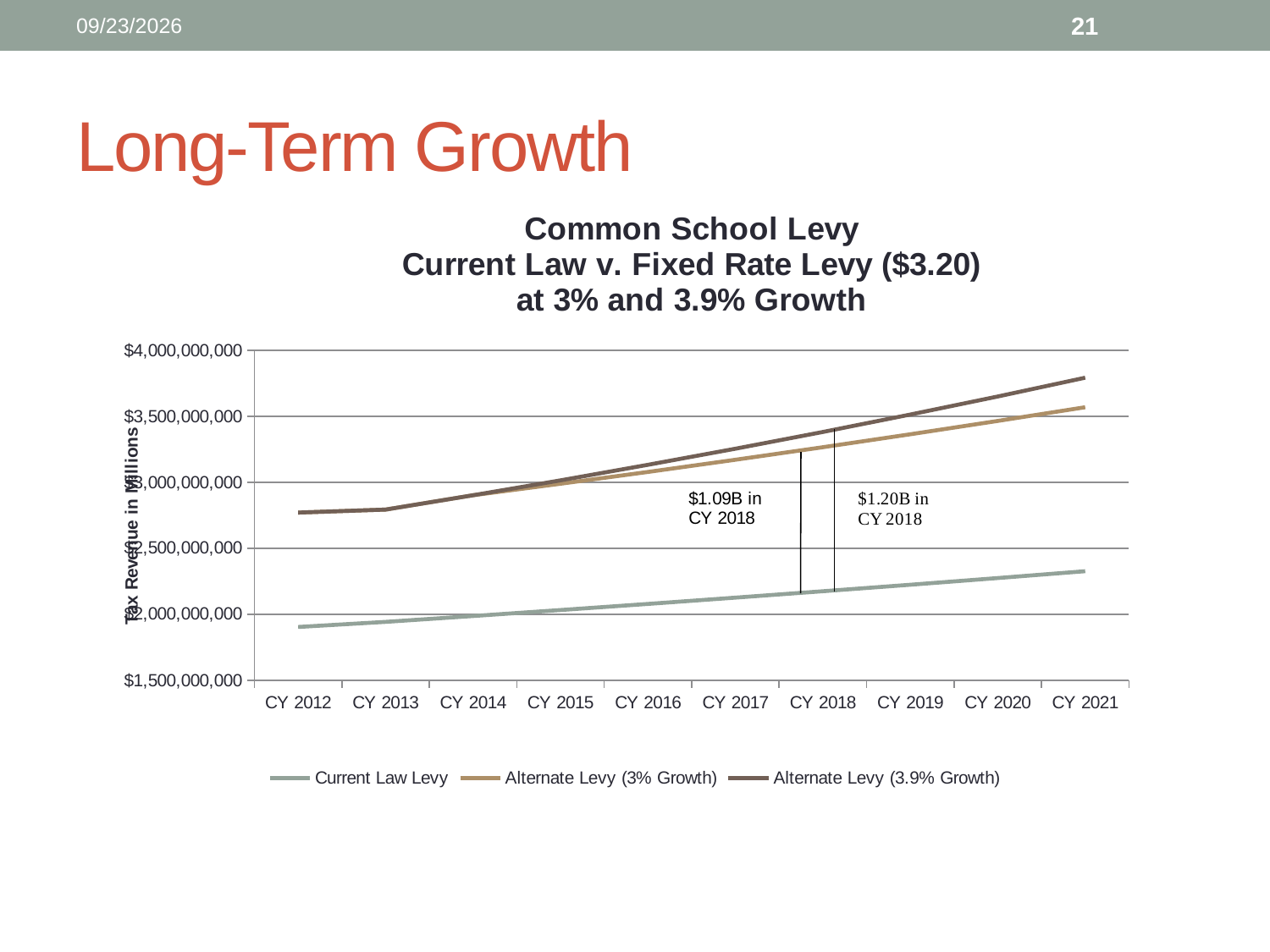
How many series does the legend list? 3 What difference does the annotation give between the Current Law Levy and the Alternate Levy (3% Growth) in CY 2018? $1.09B Which series has the highest value in CY 2021? Alternate Levy (3.9% Growth) In CY 2021, which is larger: Alternate Levy (3.9% Growth) or Alternate Levy (3% Growth)? Alternate Levy (3.9% Growth) Does the Current Law Levy line rise or fall from CY 2012 to CY 2021? rise What kind of chart is shown on the slide? line chart How many years are shown on the x axis? 10 What is the title of the y axis? Tax Revenue in Millions Which series has the lowest value in CY 2021? Current Law Levy Is the Current Law Levy value in CY 2021 greater or less than $2,500,000,000? less Is the Alternate Levy (3.9% Growth) value in CY 2021 greater or less than $3,500,000,000? greater Is the Current Law Levy value in CY 2012 greater or less than $2,000,000,000? less